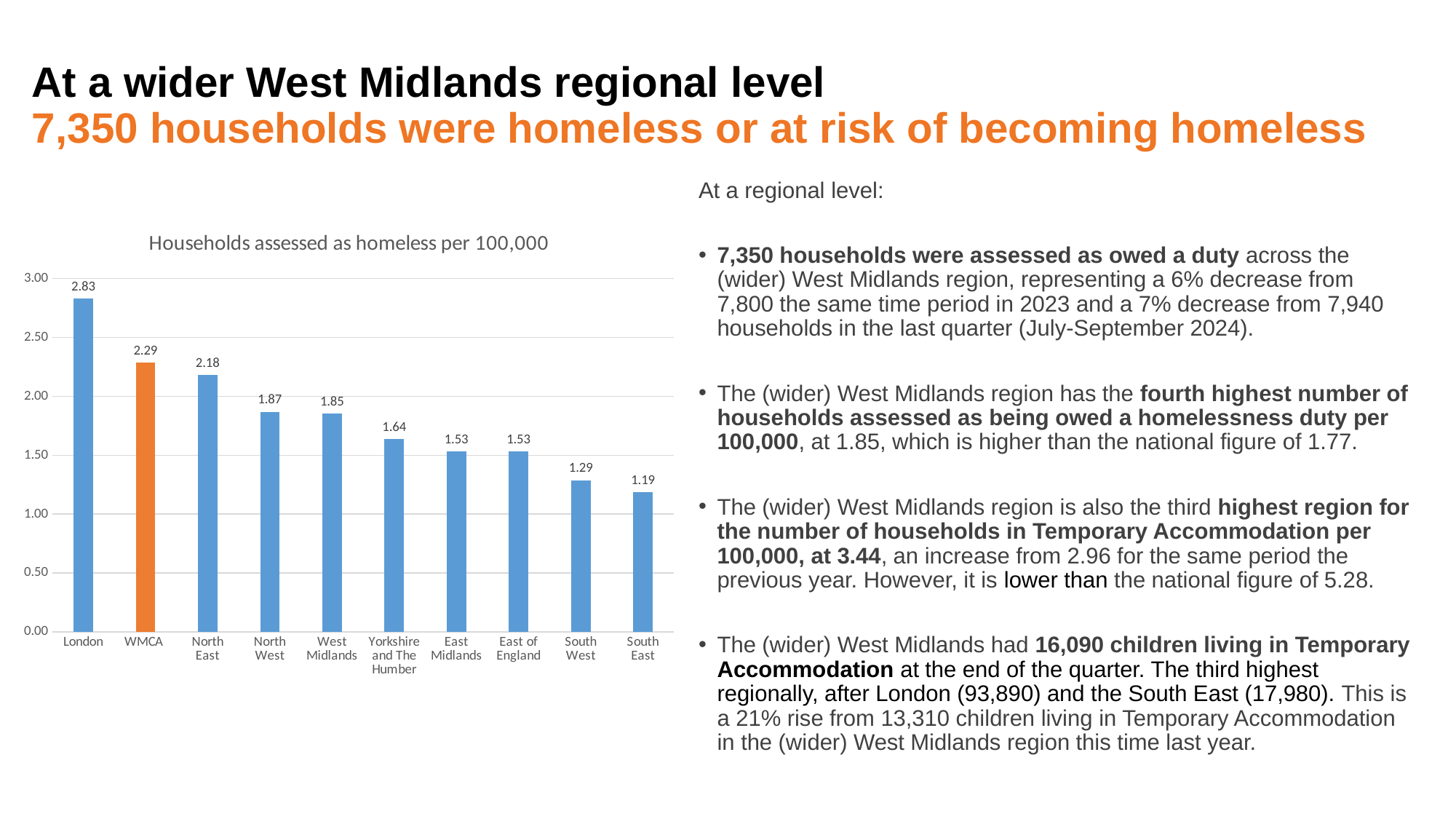
Which bar in the chart is coloured orange? WMCA What kind of chart is shown on the slide? Bar chart What is the value for Yorkshire and The Humber in the chart? 1.64 What is the value for WMCA in the chart? 2.29 What is the difference between the values for London and South East? 1.64 Is the value for South West greater or less than 1.50? less What is the value for West Midlands in the chart? 1.85 Which has a higher value, North East or North West? North East Which region has the lowest value in the chart? South East How many regions are shown in the chart? 10 What is the value for London in the chart 'Households assessed as homeless per 100,000'? 2.83 Which region has the highest value in the chart? London